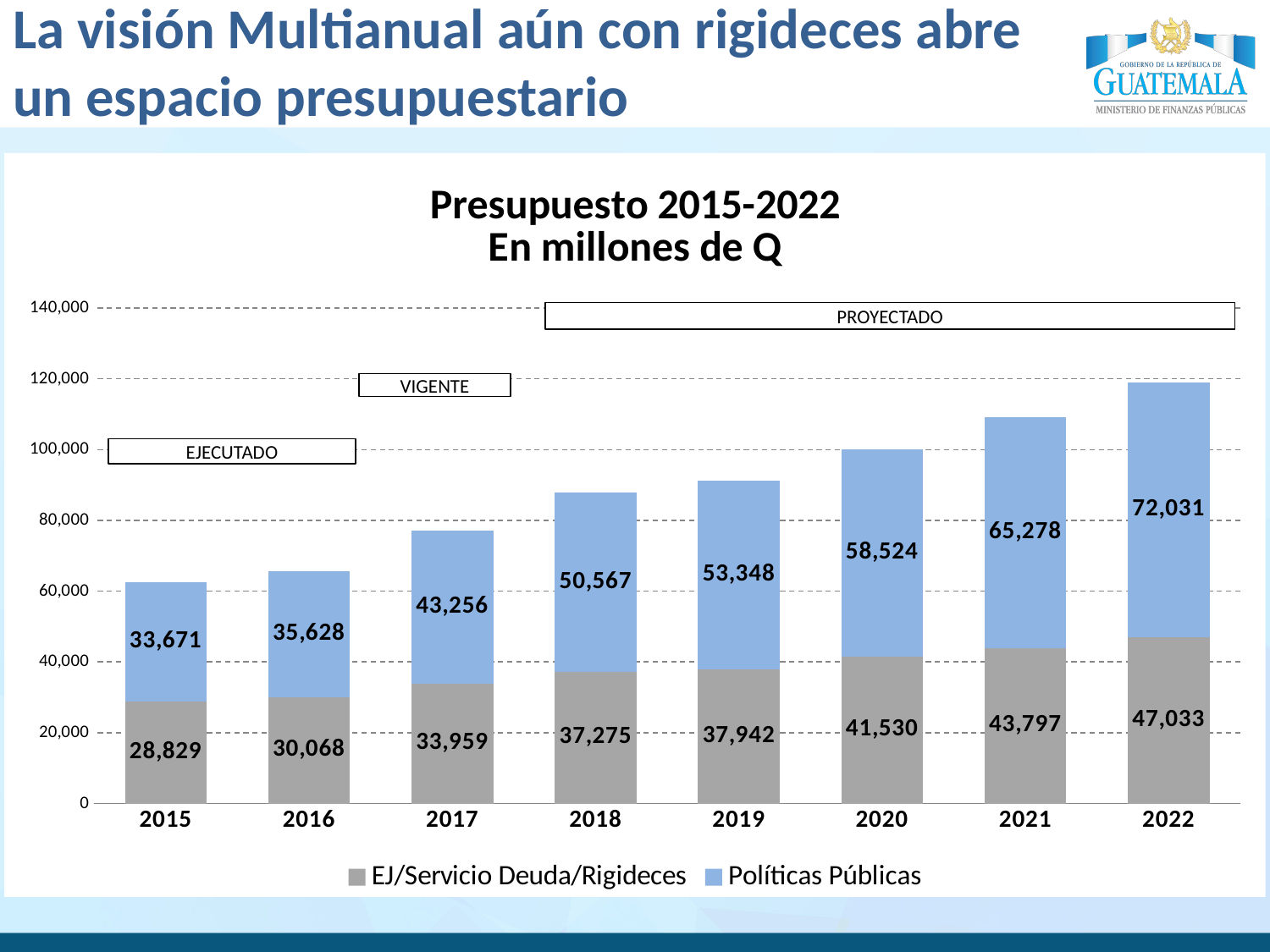
What is the title of the chart? Presupuesto 2015-2022 En millones de Q Which is larger: EJ/Servicio Deuda/Rigideces in 2019 or Políticas Públicas in 2019? Políticas Públicas in 2019 How many years are shown on the x axis? 8 What is the difference between the Políticas Públicas values for 2022 and 2015? 38,360 Which year has the lowest value for EJ/Servicio Deuda/Rigideces? 2015 How many series does the legend list? 2 Is the total stacked bar for 2022 greater or less than 100,000? greater What is the value of EJ/Servicio Deuda/Rigideces for 2017? 33,959 What is the total of the stacked bar for 2015? 62,500 What kind of chart is shown? Stacked bar chart Which year has the highest value for Políticas Públicas? 2022 What is the value of Políticas Públicas for 2020? 58,524